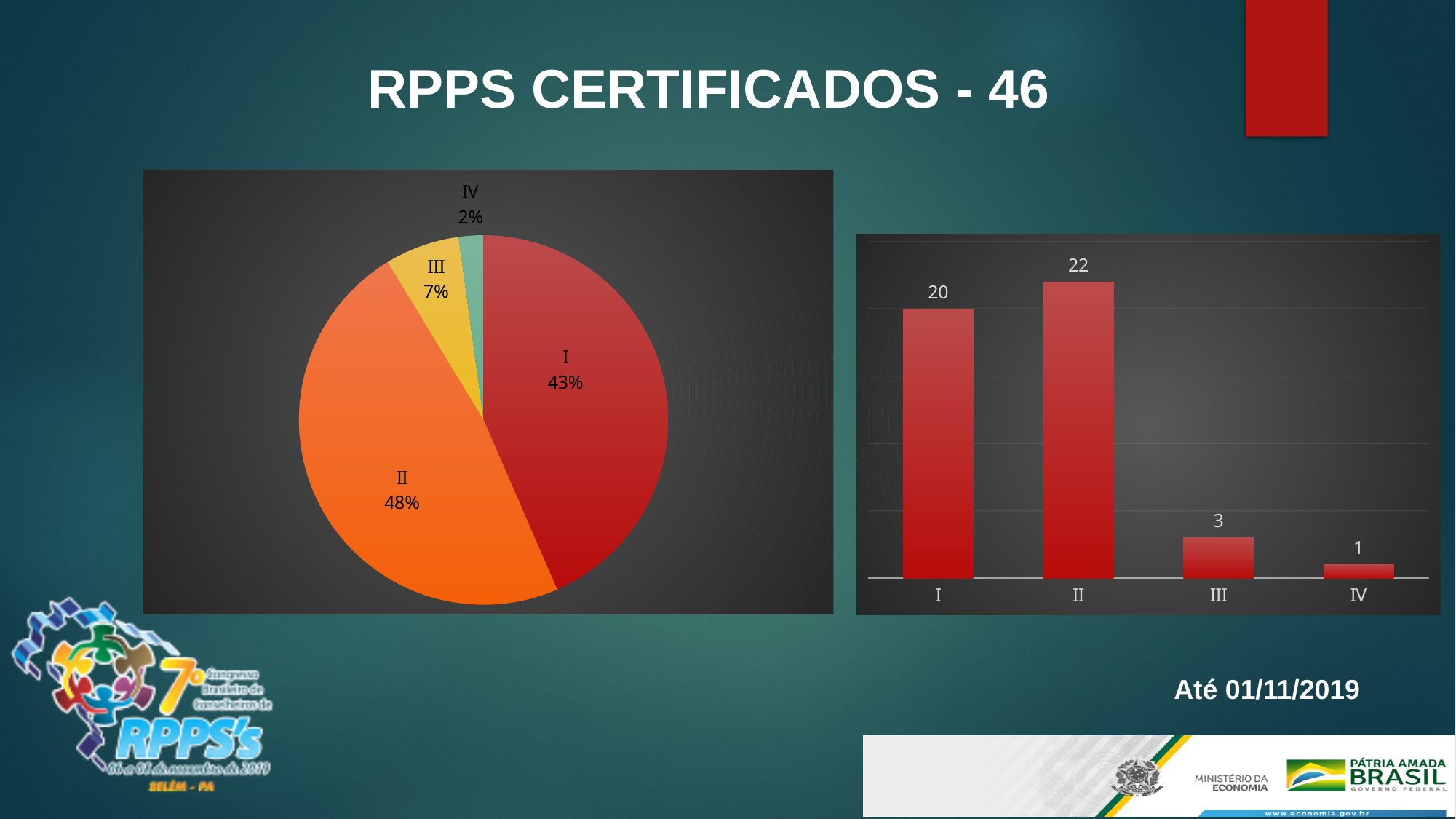
In the bar chart on the right, what is the difference between the values for II and I? 2 In the pie chart on the left, which category has the largest slice? II What kind of chart is the chart on the left? pie chart In the pie chart on the left, what share does category II have? 48% In the pie chart on the left, how many slices are there? 4 What kind of chart is the chart on the right? bar chart In the bar chart on the right, which category has the lowest value? IV In the bar chart on the right, what is the value for category III? 3 In the bar chart on the right, which is larger, the value for I or the value for III? I In the pie chart on the left, what share does category IV have? 2% In the pie chart on the left, which category has the smallest slice? IV In the bar chart on the right, what is the value for category II? 22